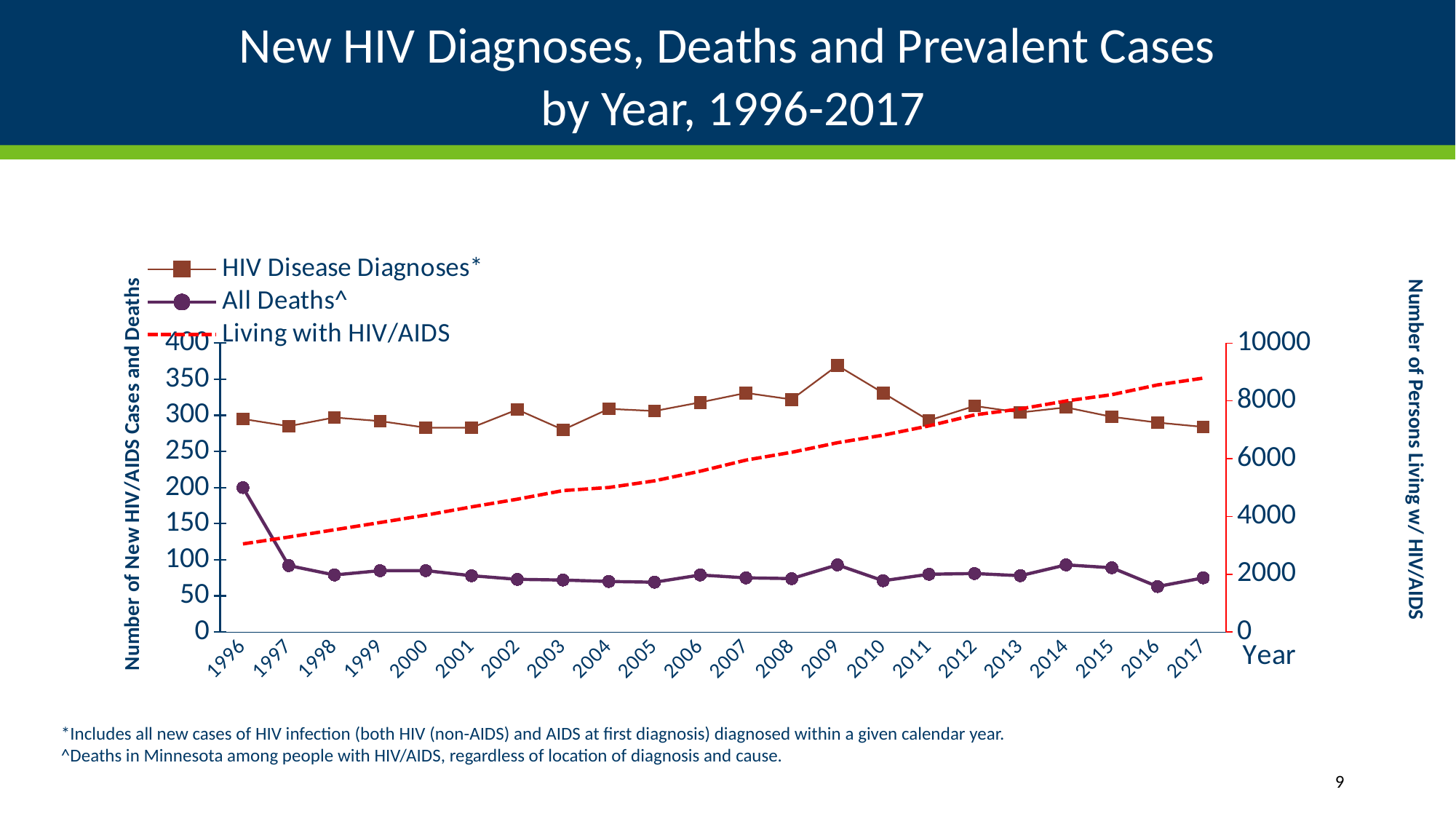
Is the Living with HIV/AIDS value for 2017 greater or less than 8000? greater In which year is the Living with HIV/AIDS series at its lowest? 1996 In which year is the HIV Disease Diagnoses series at its highest? 2009 Is the HIV Disease Diagnoses value for 2009 greater or less than 350? greater In which year is the All Deaths series at its highest? 1996 What kind of chart is shown on the slide? Line chart How many years are plotted along the x axis? 22 Which is larger, the All Deaths value for 1996 or for 1997? 1996 How many series does the legend list? 3 Is the All Deaths value for 2016 greater or less than 100? less Does the Living with HIV/AIDS series rise or fall from 1996 to 2017? rise What is the title of the right-hand vertical axis? Number of Persons Living w/ HIV/AIDS